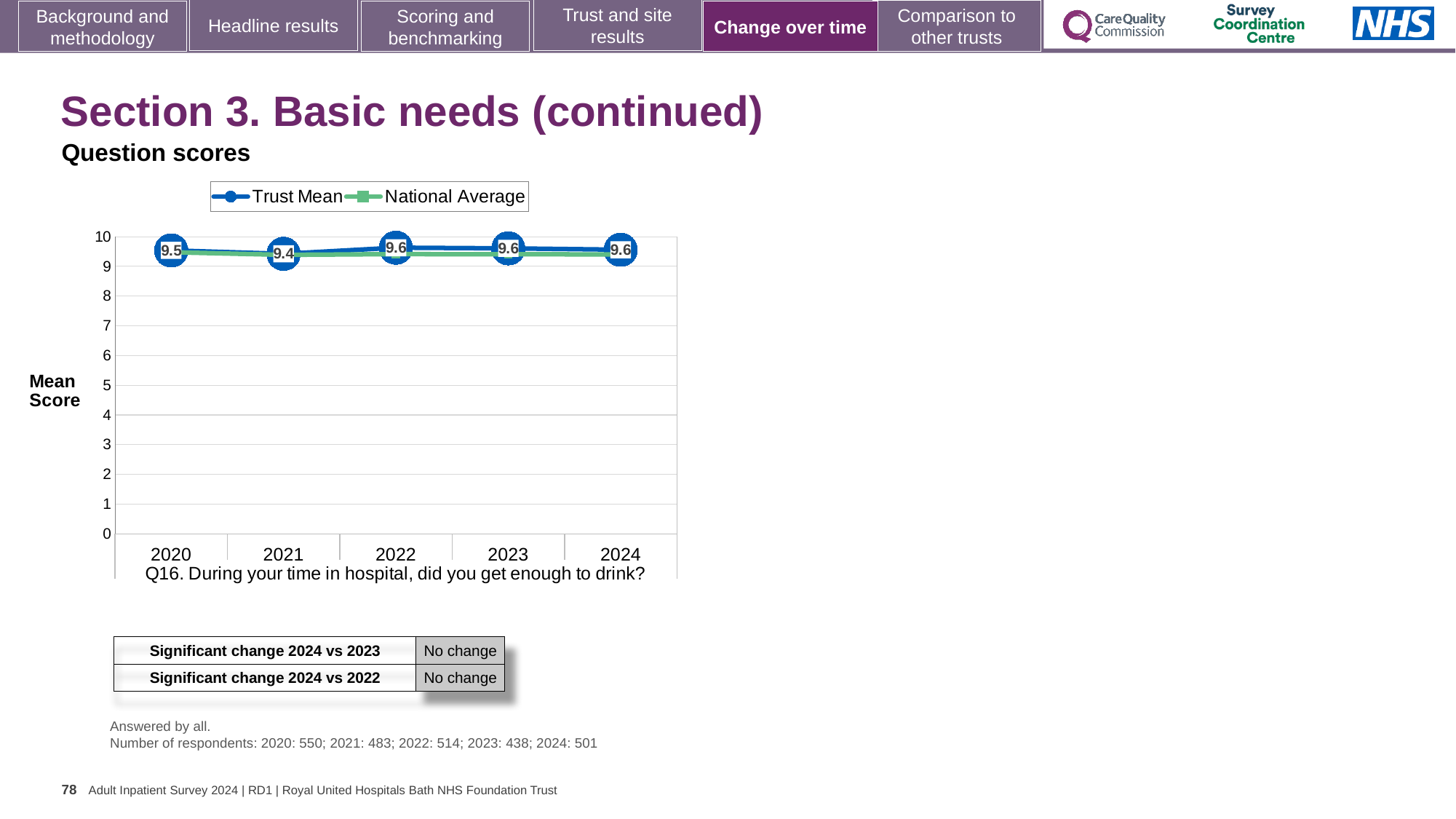
Which survey question does the chart show scores for? Q16. During your time in hospital, did you get enough to drink? What kind of chart is shown on the slide? Line chart How many years are plotted on the x axis? 5 What is the difference between the Trust Mean score in 2024 and in 2021? 0.2 Does the Trust Mean score rise or fall from 2021 to 2022? Rise In which year is the Trust Mean score lowest? 2021 What is the Trust Mean score for 2020? 9.5 What is the Trust Mean score for 2021? 9.4 How many series does the legend list? 2 Which is larger, the Trust Mean score for 2022 or for 2021? 2022 What is the Trust Mean score for 2024? 9.6 Is the National Average value for 2023 greater or less than 9? greater